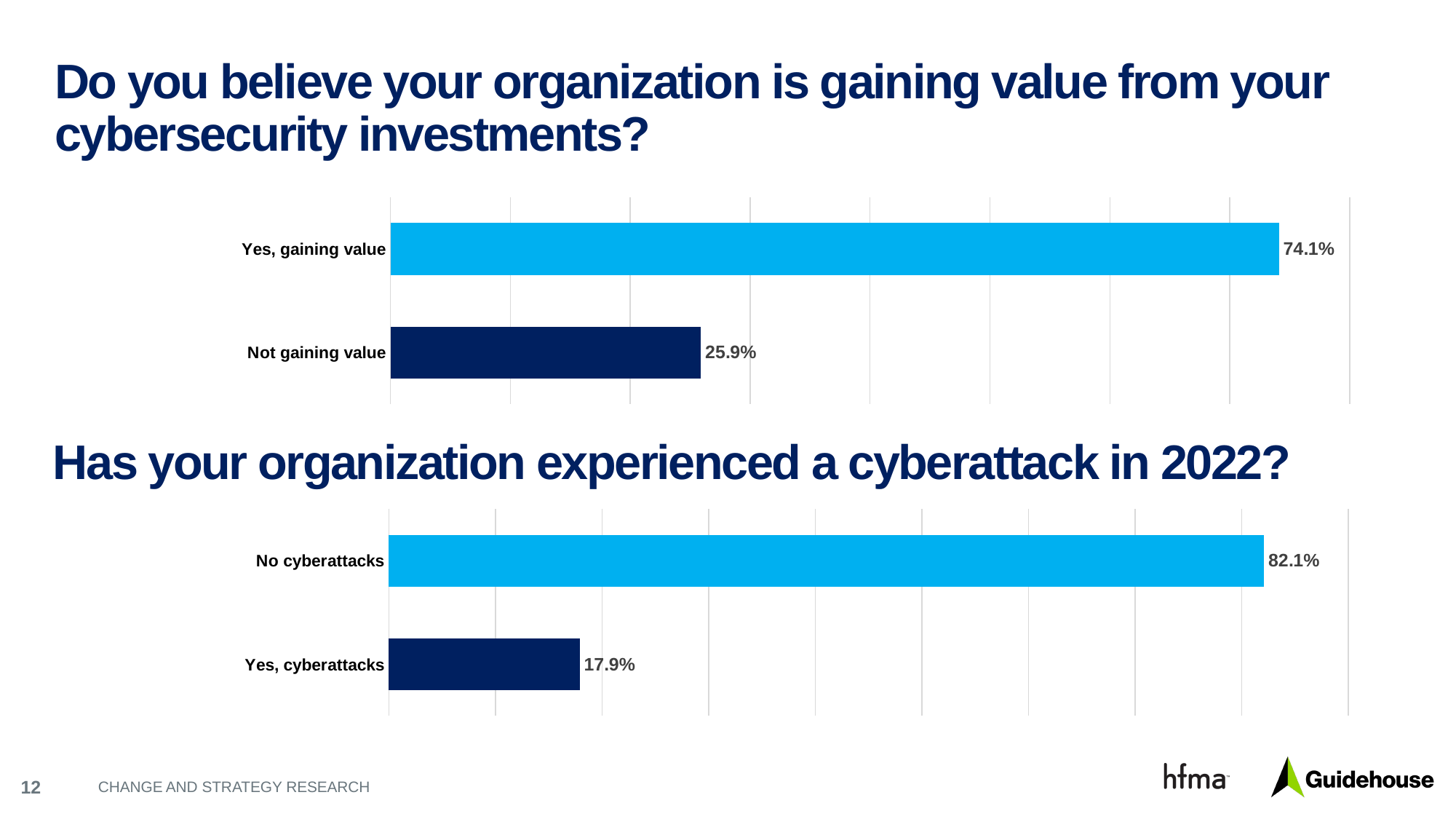
How many categories are shown in the bottom chart (cyberattack in 2022)? 2 In the bottom chart (cyberattack in 2022), what is the value for "Yes, cyberattacks"? 17.9% In the top chart (gaining value from cybersecurity investments), what is the difference between "Yes, gaining value" and "Not gaining value"? 48.2% In the top chart (gaining value from cybersecurity investments), what is the value for "Yes, gaining value"? 74.1% Which is larger: "Not gaining value" in the top chart or "Yes, cyberattacks" in the bottom chart? Not gaining value What kind of chart is the top chart (gaining value from cybersecurity investments)? Bar chart In the bottom chart (cyberattack in 2022), what is the value for "No cyberattacks"? 82.1% What is the title of the bottom chart? Has your organization experienced a cyberattack in 2022? In the bottom chart (cyberattack in 2022), what is the difference between "No cyberattacks" and "Yes, cyberattacks"? 64.2% In the top chart (gaining value from cybersecurity investments), what is the value for "Not gaining value"? 25.9% In the top chart (gaining value from cybersecurity investments), which category has the highest value? Yes, gaining value In the bottom chart (cyberattack in 2022), which category has the lowest value? Yes, cyberattacks